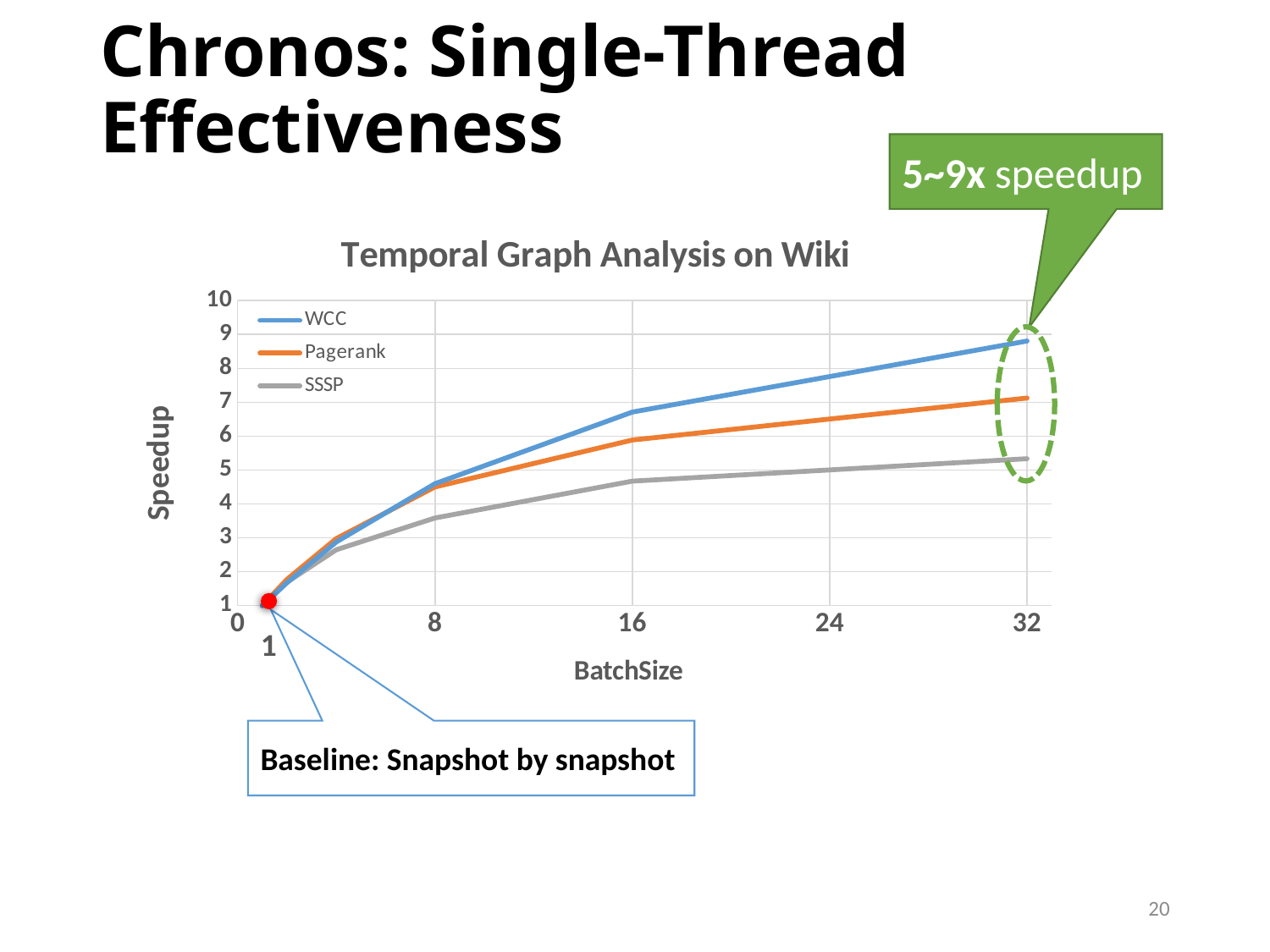
What is the title of the chart? Temporal Graph Analysis on Wiki At batch size 16, which series has the larger speedup, WCC or SSSP? WCC Is the speedup for SSSP at batch size 32 greater or less than 6? less Is the speedup for SSSP at batch size 8 greater or less than 4? less Does the speedup for WCC rise or fall as batch size increases? rise Which series has the highest speedup at batch size 32? WCC Is the speedup for WCC at batch size 32 greater or less than 8? greater How many series does the chart's legend list? 3 What is the label of the x axis? BatchSize What kind of chart is shown on the slide? line chart Which series has the lowest speedup at batch size 32? SSSP